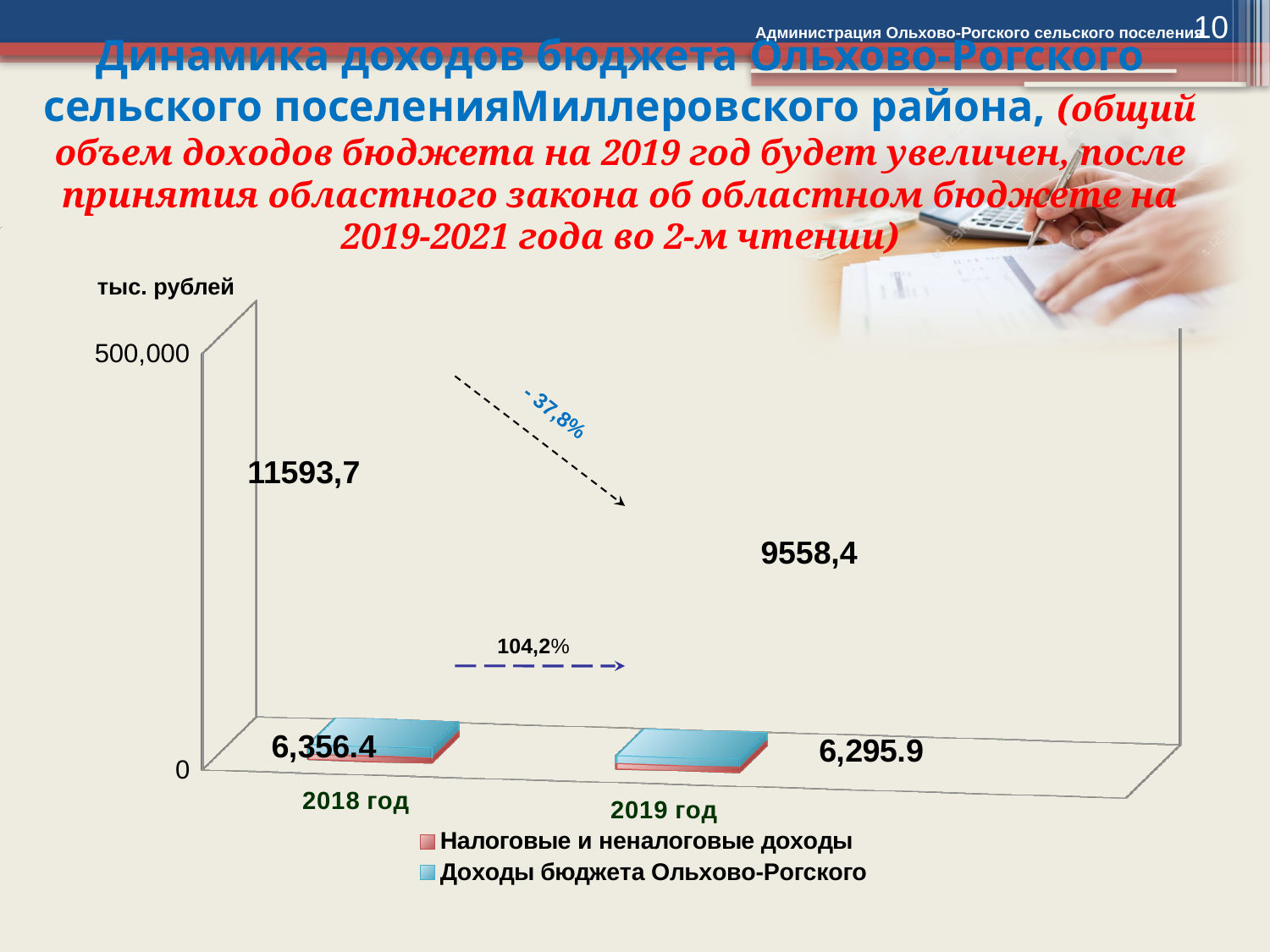
What is the smaller value labelled for 2019 год? 6,295.9 What is the larger value labelled for 2019 год? 9558,4 What is the smaller value labelled for 2018 год? 6,356.4 What is the larger value labelled for 2018 год? 11593,7 How many series does the chart legend list? 2 Do the labelled values rise or fall from 2018 год to 2019 год? fall What percentage is written on the downward dashed arrow between the two years? - 37,8% What is the difference between the smaller labelled values for 2018 год (6,356.4) and 2019 год (6,295.9)? 60.5 Which year has the larger of the two upper labelled values, 2018 год or 2019 год? 2018 год How many year categories are shown on the x axis of the chart? 2 What kind of chart is shown on the slide? bar chart What is the difference between the larger labelled values for 2018 год (11593,7) and 2019 год (9558,4)? 2035,3